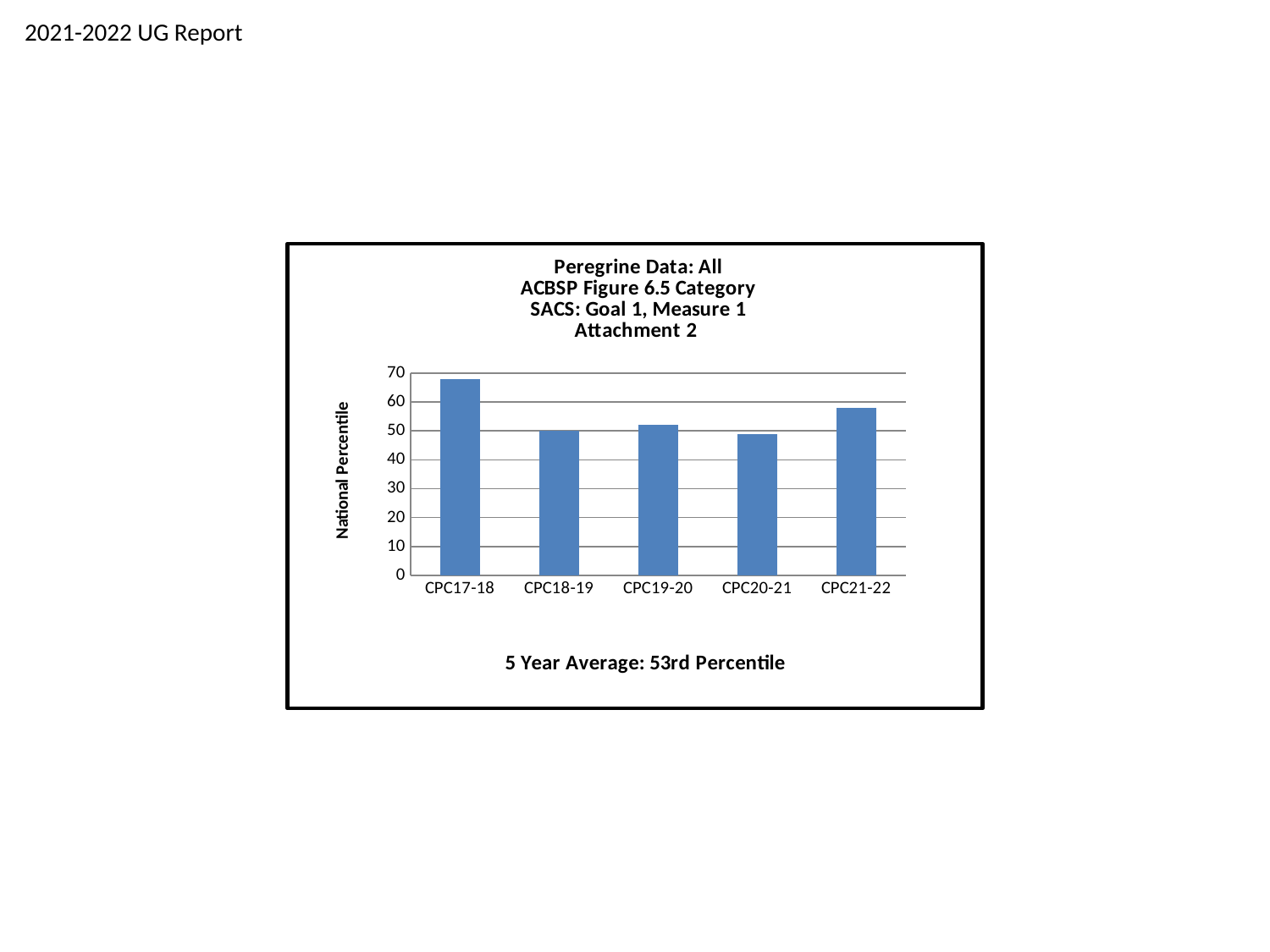
Is the value for CPC21-22 greater or less than 60? less Which is larger, the value for CPC17-18 or the value for CPC21-22? CPC17-18 Is the value for CPC21-22 greater or less than 50? greater Is the value for CPC20-21 greater or less than 40? greater How many categories are plotted on the x axis of the chart? 5 What is the label of the y axis of the chart? National Percentile What 5 year average is stated below the chart? 53rd Percentile Which is larger, the value for CPC21-22 or the value for CPC19-20? CPC21-22 Which category has the highest national percentile? CPC17-18 What kind of chart is shown on the slide? bar chart